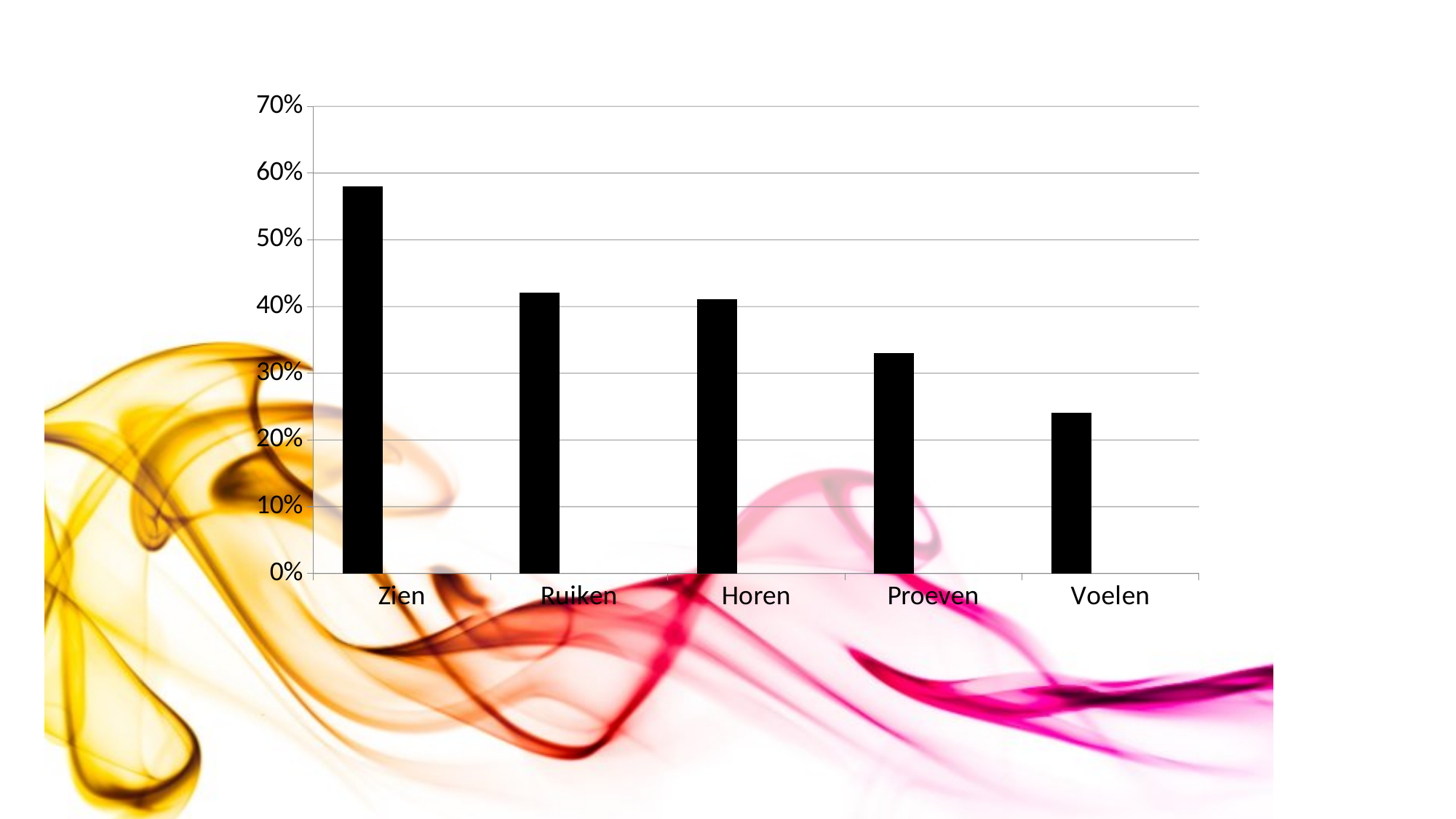
Which is larger, the value for Proeven or the value for Voelen? Proeven Which category has the highest value? Zien Which is larger, the value for Zien or the value for Ruiken? Zien What kind of chart is shown on the slide? bar chart Is the value for Voelen greater or less than 30%? less Is the value for Zien greater or less than 50%? greater Which category has the lowest value? Voelen Is the value for Horen greater or less than 50%? less How many categories are shown on the x axis? 5 Do the values rise or fall from Zien to Voelen along the x axis? fall